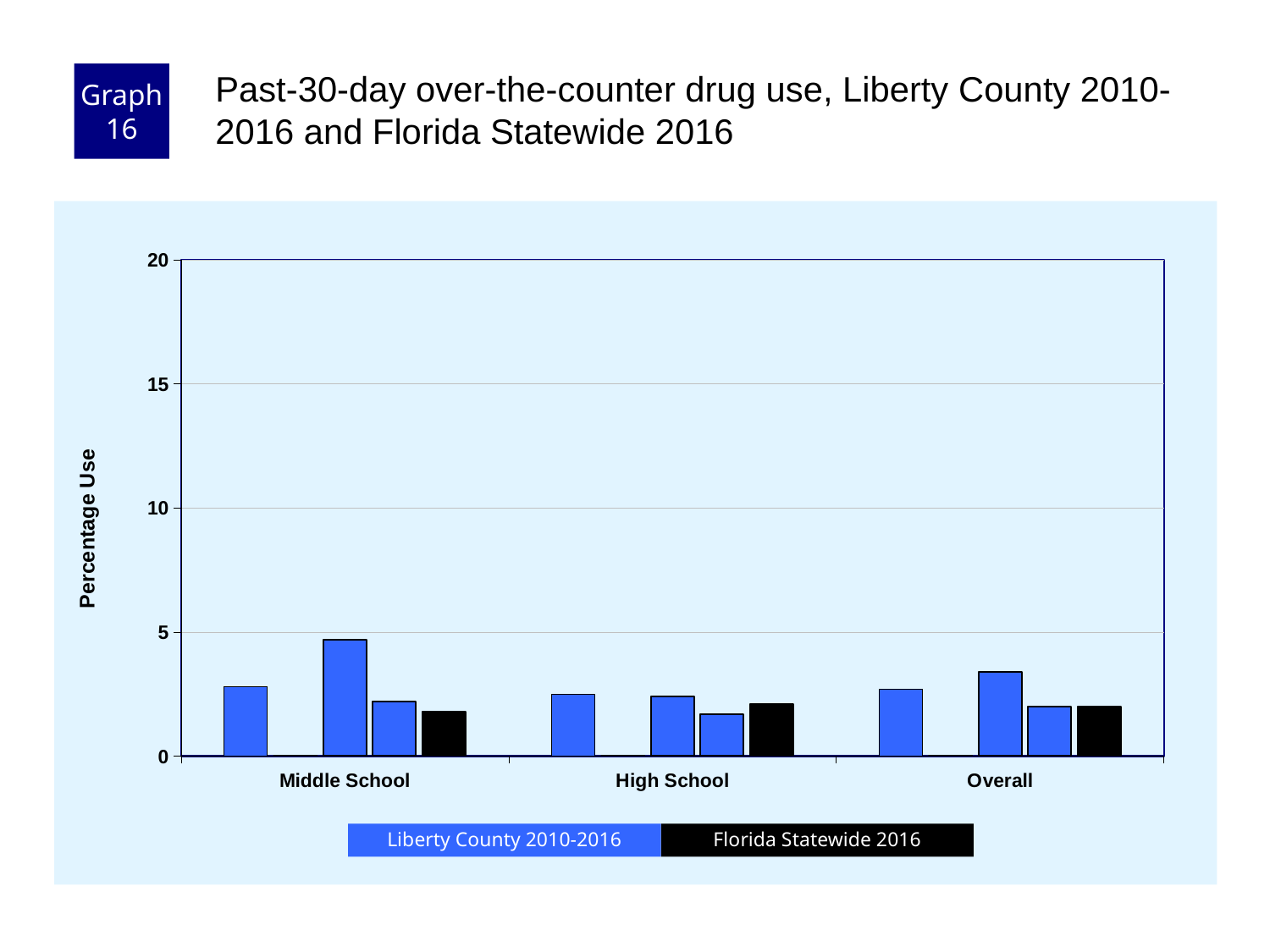
How many series does the legend list? 2 Is the value for Florida Statewide 2016 in the Middle School category greater or less than 5? less How many categories are shown on the x axis? 3 What kind of chart is shown on the slide? bar chart Are any of the bars on the chart greater than 10? no Is the tallest Liberty County bar in the Middle School category greater or less than 5? less What is the label of the y axis? Percentage Use Which colour represents Florida Statewide 2016 in the legend? black Which category contains the tallest bar on the chart? Middle School What is the highest value shown on the y axis? 20